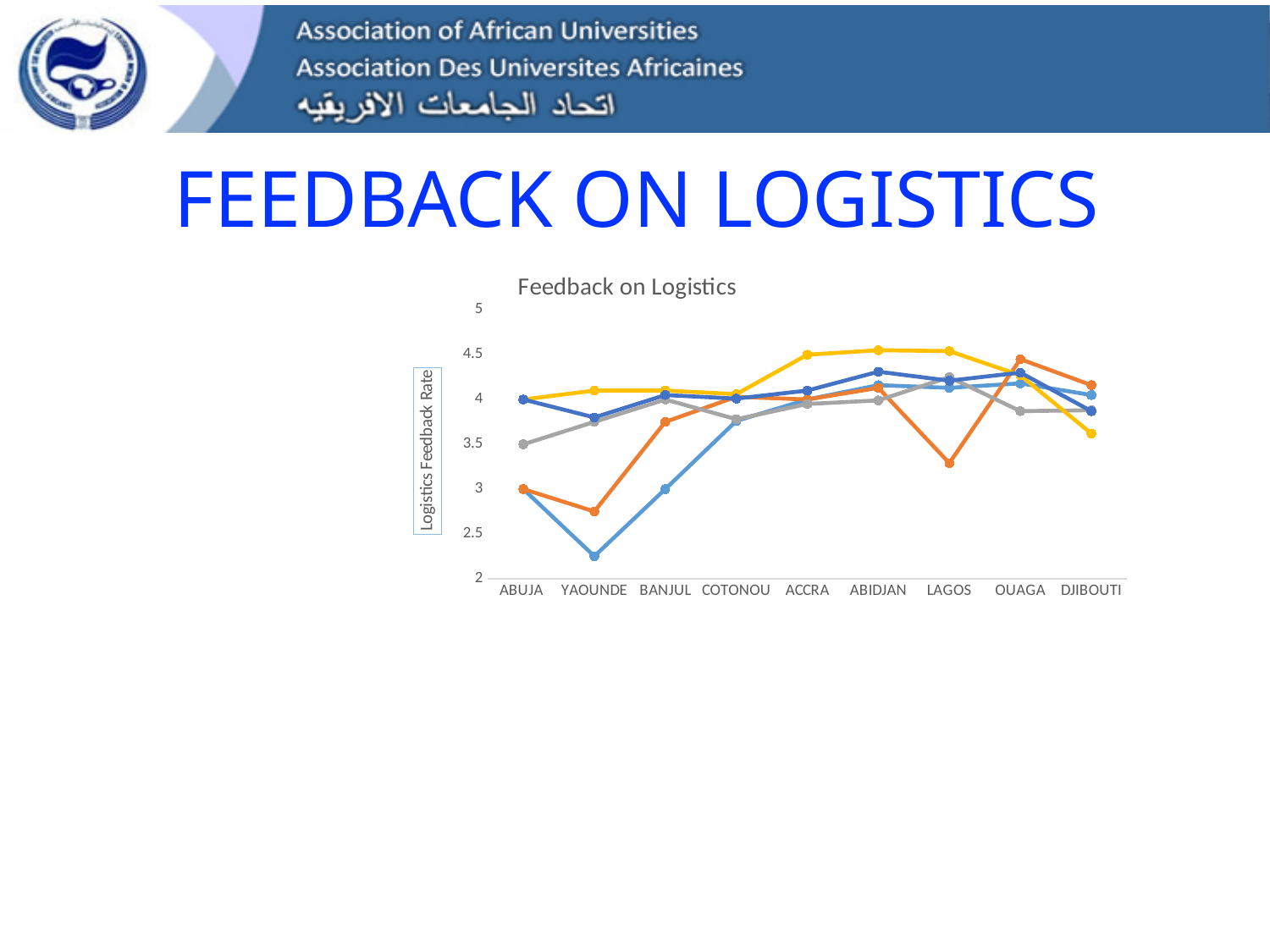
What is the title of the chart? Feedback on Logistics At which city does the light blue line reach its lowest value? YAOUNDE Is the value of the orange line at YAOUNDE greater or less than 3? less On the orange line, which is larger: the value at LAGOS or the value at OUAGA? OUAGA Is the value of the orange line at LAGOS greater or less than 3.5? less Does the light blue line rise or fall from YAOUNDE to ABIDJAN? rise What kind of chart is shown on the slide? line chart How many lines are plotted on the chart? 5 Is the value of the light blue line at YAOUNDE greater or less than 2.5? less How many cities are listed along the x axis of the chart? 9 What is the label on the vertical axis of the chart? Logistics Feedback Rate